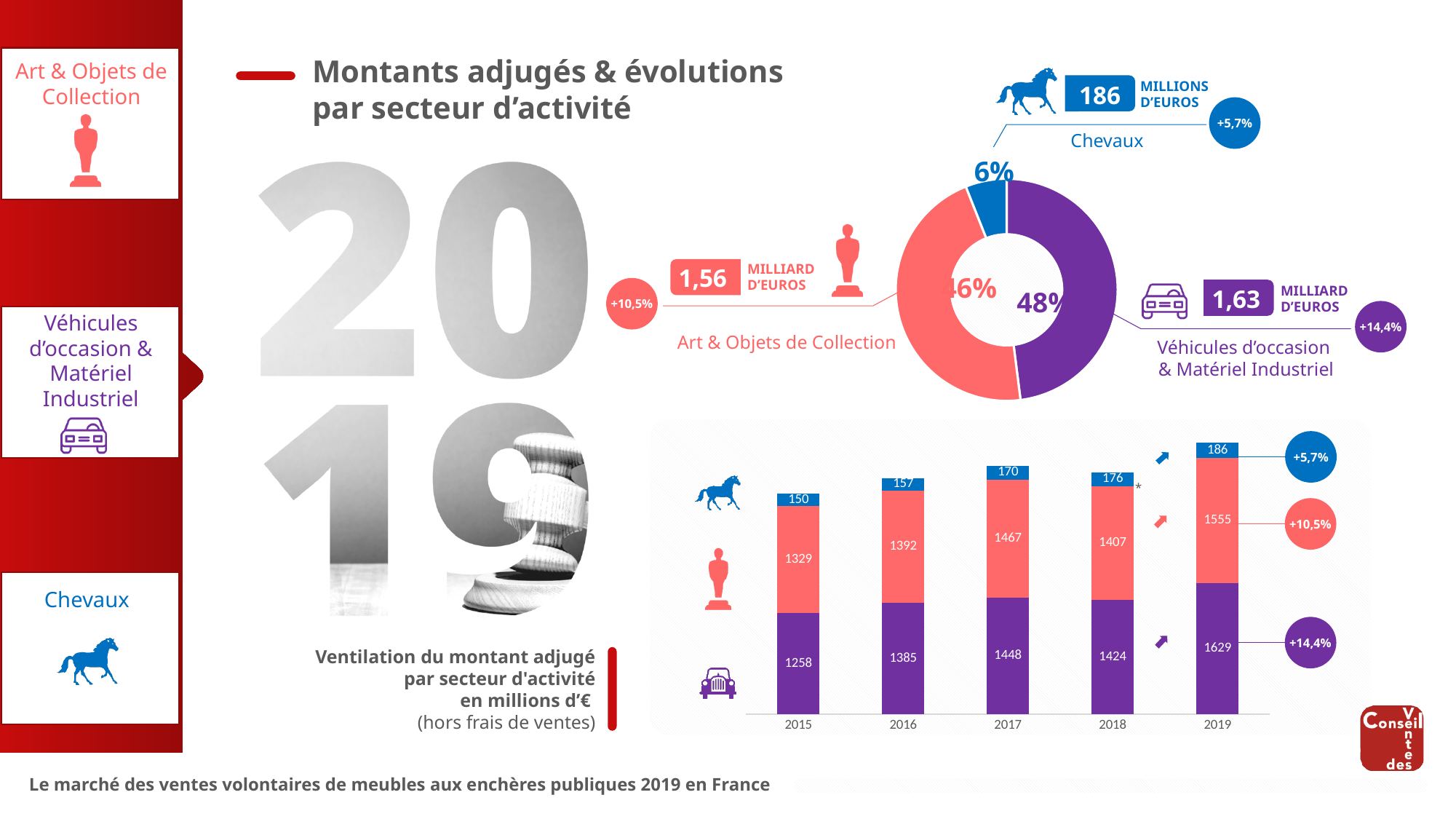
In the stacked bar chart at the bottom, what is the difference between the Chevaux value in 2019 and in 2015? 36 In the stacked bar chart at the bottom, what is the value for Véhicules d'occasion & Matériel Industriel in 2019? 1629 What kind of chart is the chart at the top right showing sector shares? Pie chart (donut) In the stacked bar chart at the bottom, which year has the larger Art & Objets de Collection value, 2017 or 2018? 2017 In the donut chart, what share of the total does Chevaux represent? 6% In the donut chart, what share does Véhicules d'occasion & Matériel Industriel represent? 48% In the stacked bar chart at the bottom, what is the total of the 2019 bar? 3370 In the stacked bar chart at the bottom, what is the value for Chevaux in 2017? 170 How many years are shown on the x axis of the stacked bar chart at the bottom? 5 What kind of chart is the chart at the bottom showing values from 2015 to 2019? Stacked bar chart In the stacked bar chart at the bottom, does the Chevaux value rise or fall from 2015 to 2019? Rises In the donut chart, which sector has the largest share? Véhicules d'occasion & Matériel Industriel